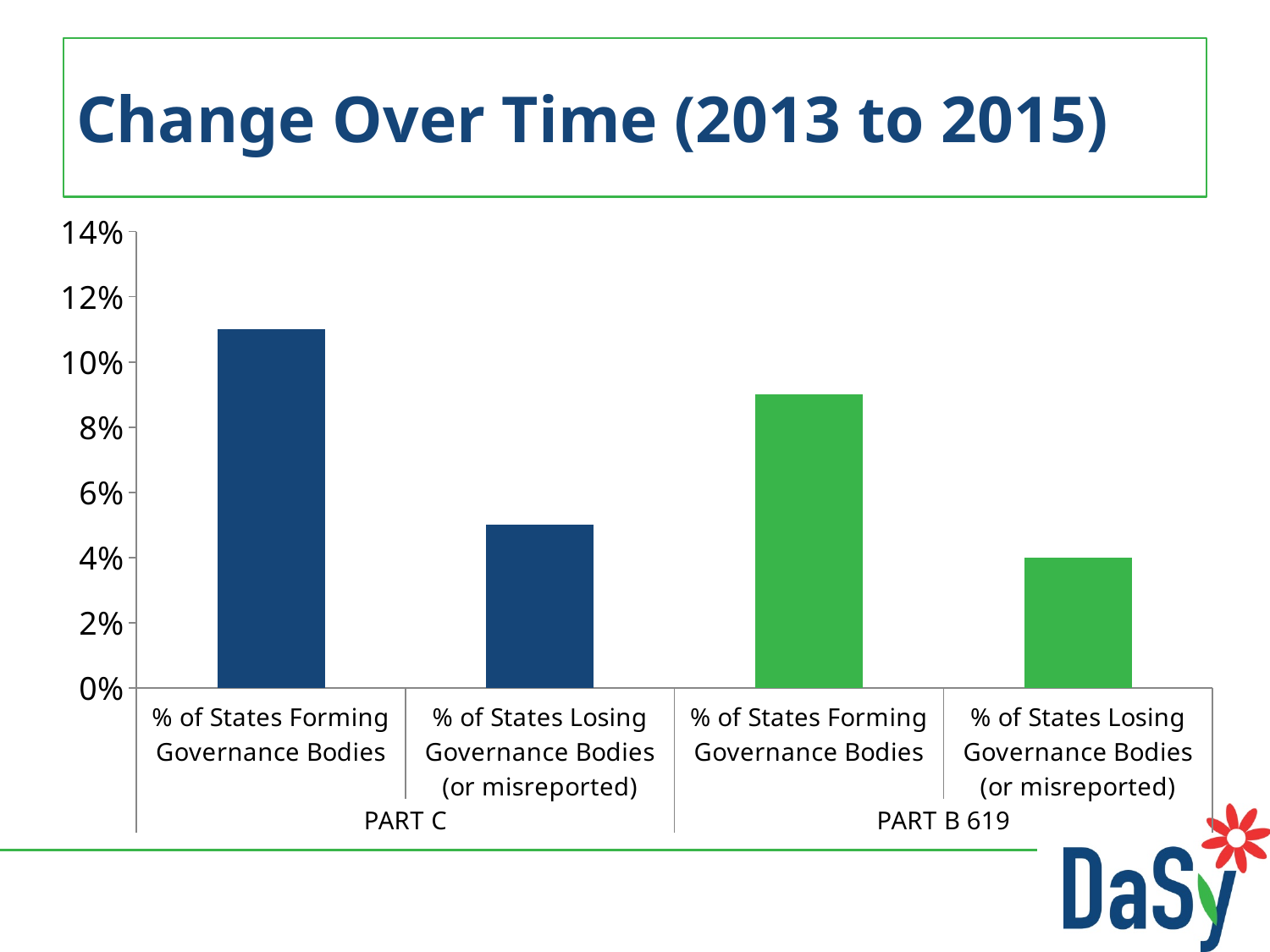
How many bars are plotted in the chart? 4 What kind of chart is shown on the slide? bar chart Is the value for % of States Forming Governance Bodies under PART B 619 greater or less than 10%? less What colour are the bars for the PART B 619 group? green Is the value for % of States Forming Governance Bodies under PART C greater or less than 10%? greater Which bar has the highest value in the chart? % of States Forming Governance Bodies (PART C) What is the title of the chart on the slide? Change Over Time (2013 to 2015) Which bar has the lowest value in the chart? % of States Losing Governance Bodies (or misreported) (PART B 619) Which is larger: % of States Losing Governance Bodies (or misreported) for PART C or for PART B 619? PART C Is the value for % of States Forming Governance Bodies under PART B 619 greater or less than 8%? greater Which is larger: % of States Forming Governance Bodies for PART C or for PART B 619? PART C